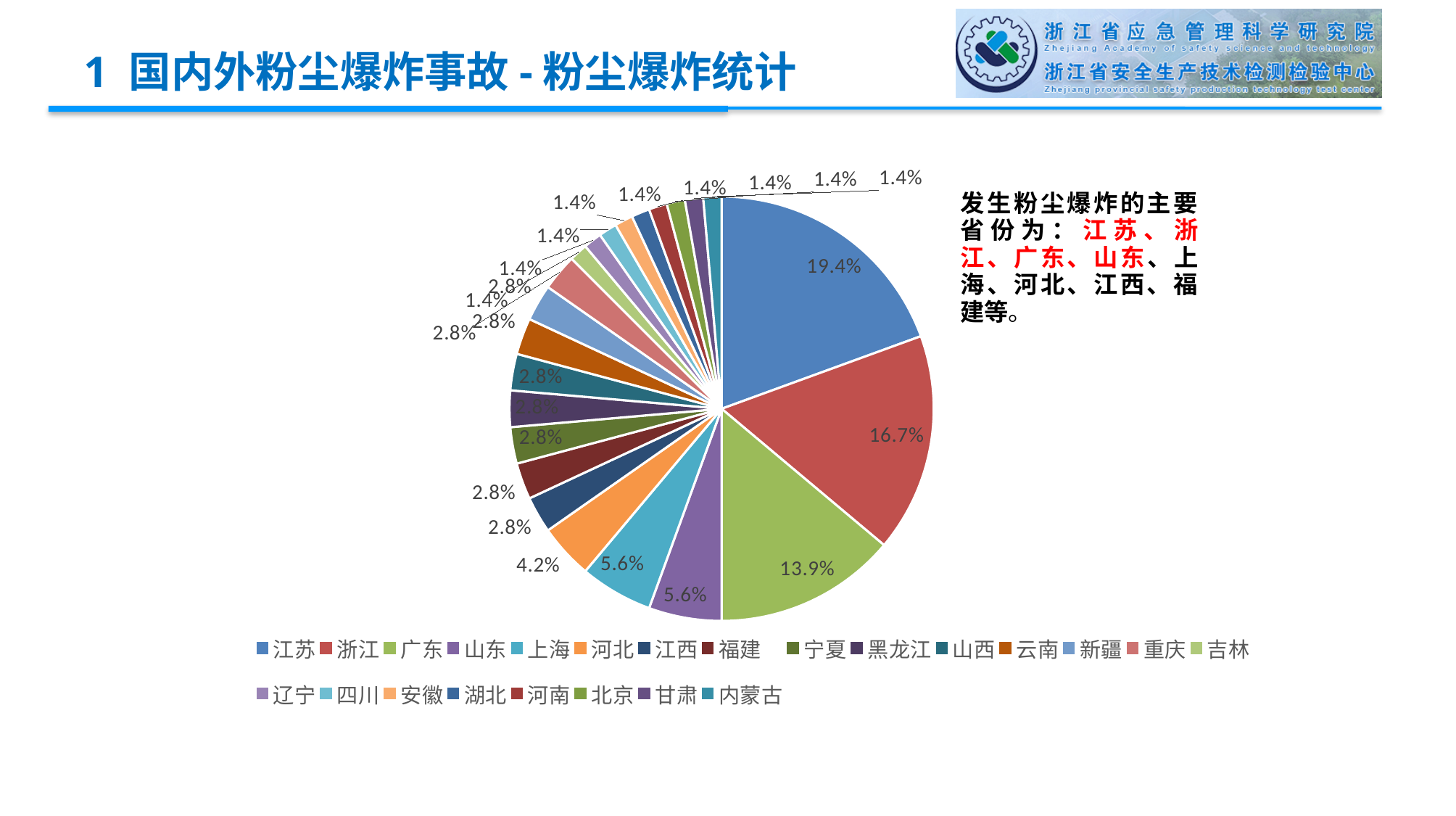
What share of the pie does 江苏 account for? 19.4% What is the difference between the shares of 江苏 and 浙江? 2.7% Which province has the largest share of the pie? 江苏 What kind of chart is shown on the slide? pie chart How many provinces are listed in the legend of the pie chart? 23 What is the difference between the shares of 浙江 and 广东? 2.8% What is the value shown for 广东? 13.9% What colour is the slice for 江苏? blue What is the value shown for 河北? 4.2% What is the value shown for 浙江? 16.7% Which has a larger share, 广东 or 山东? 广东 What is the value shown for 上海? 5.6%